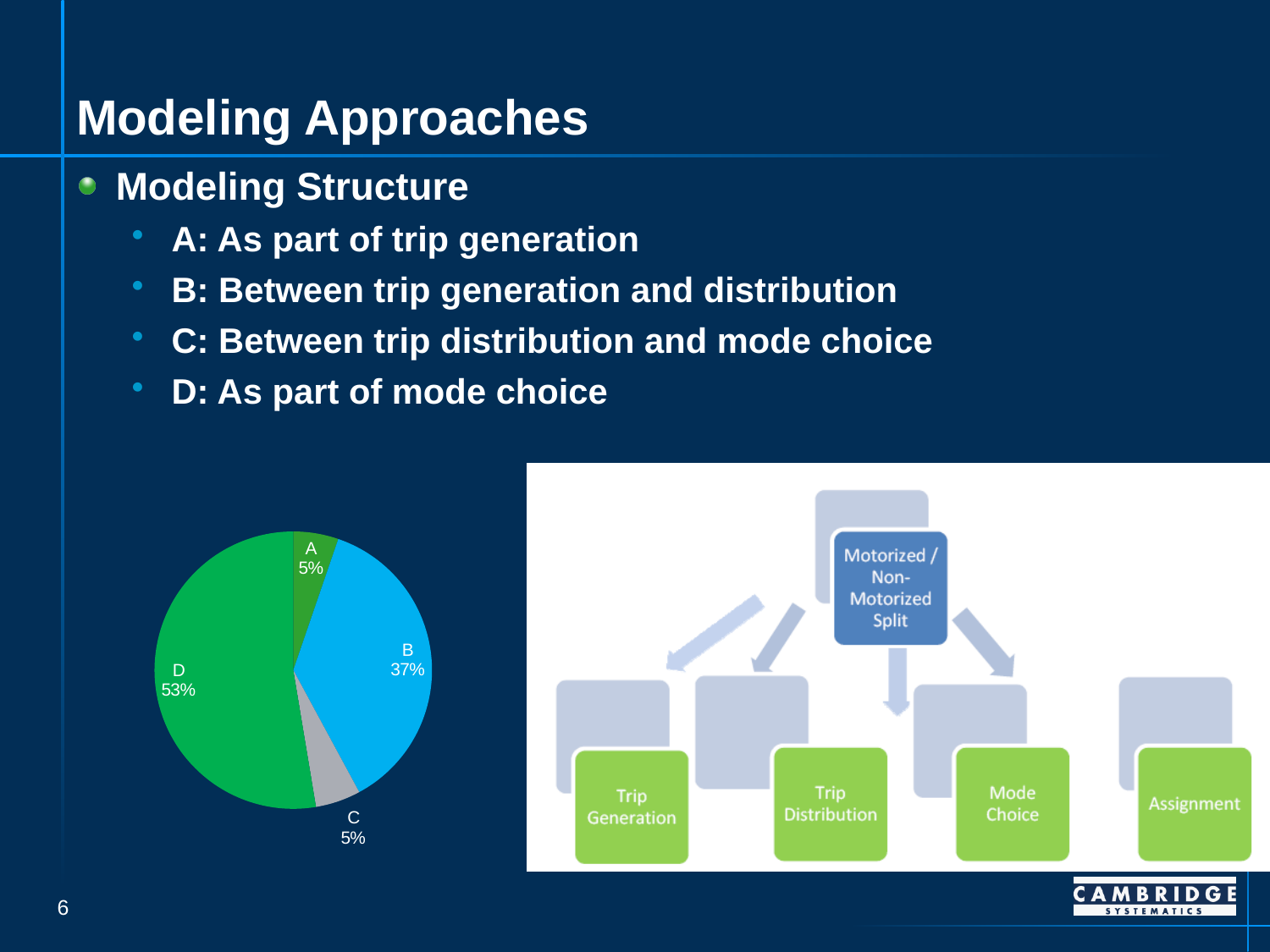
In the pie chart, which is larger, slice B or slice D? D Which slice of the pie chart is the largest? D How many slices does the pie chart have? 4 What kind of chart is shown on the left of the slide? pie chart In the pie chart, what share does slice B have? 37% In the pie chart, what is the difference between the shares of D and B? 16% What colour is slice D in the pie chart? green In the pie chart, what share does slice C have? 5% In the pie chart, what share does slice D have? 53% In the pie chart, what is the combined share of slices A and C? 10% In the pie chart, what share does slice A have? 5% In the pie chart, is the share for B greater or less than 50%? less